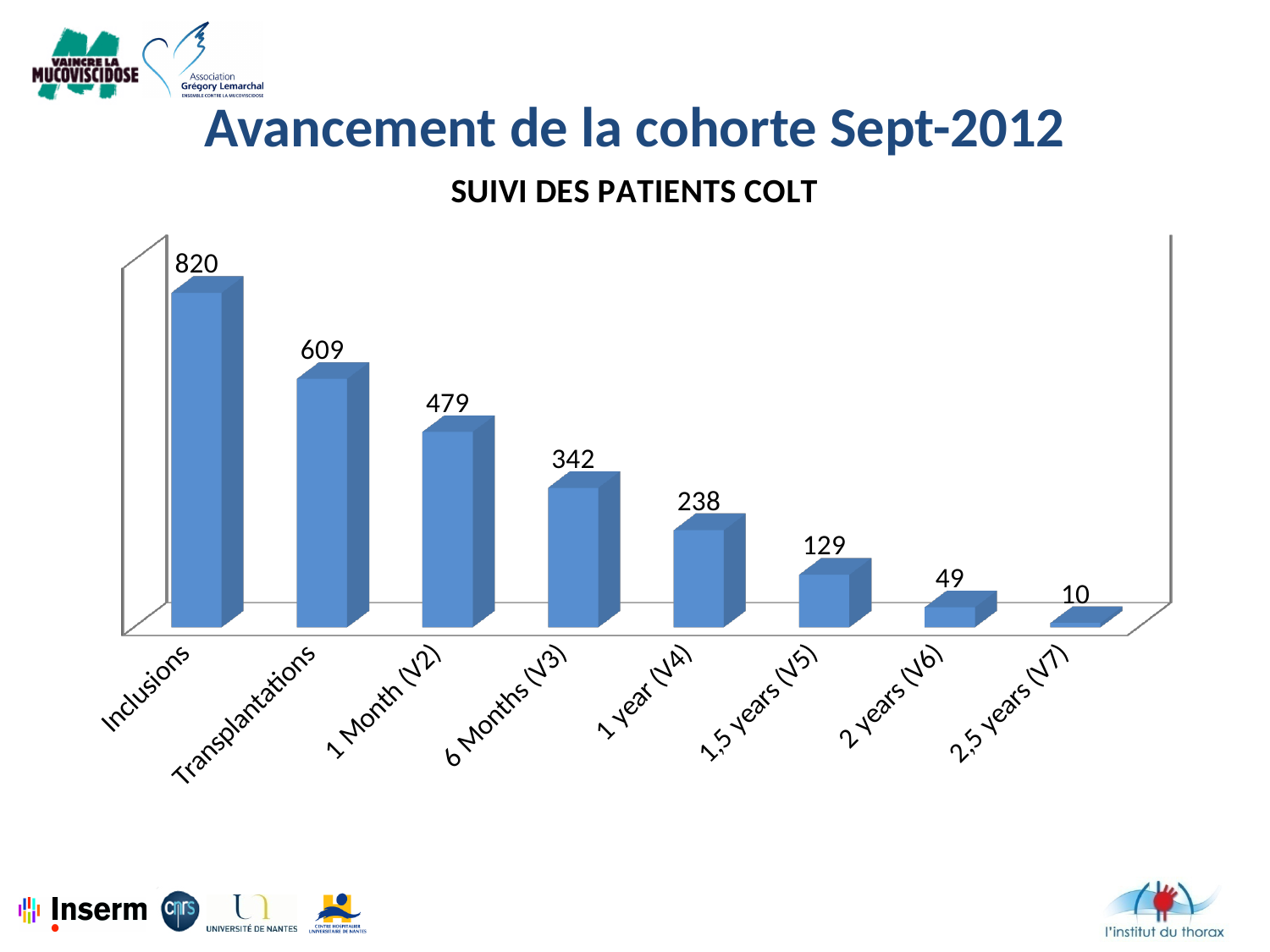
What kind of chart is shown on the slide? bar chart Do the values rise or fall from left to right along the x axis? fall Which is larger, the value for 1 Month (V2) or the value for 6 Months (V3)? 1 Month (V2) What is the value for 6 Months (V3)? 342 How many categories are shown on the x axis? 8 What is the difference between the values for Inclusions and Transplantations? 211 Which category has the highest value? Inclusions What is the value for 2,5 years (V7)? 10 What is the value for Transplantations? 609 Which category has the lowest value? 2,5 years (V7) What is the difference between the values for 1 year (V4) and 1,5 years (V5)? 109 What is the value for Inclusions? 820